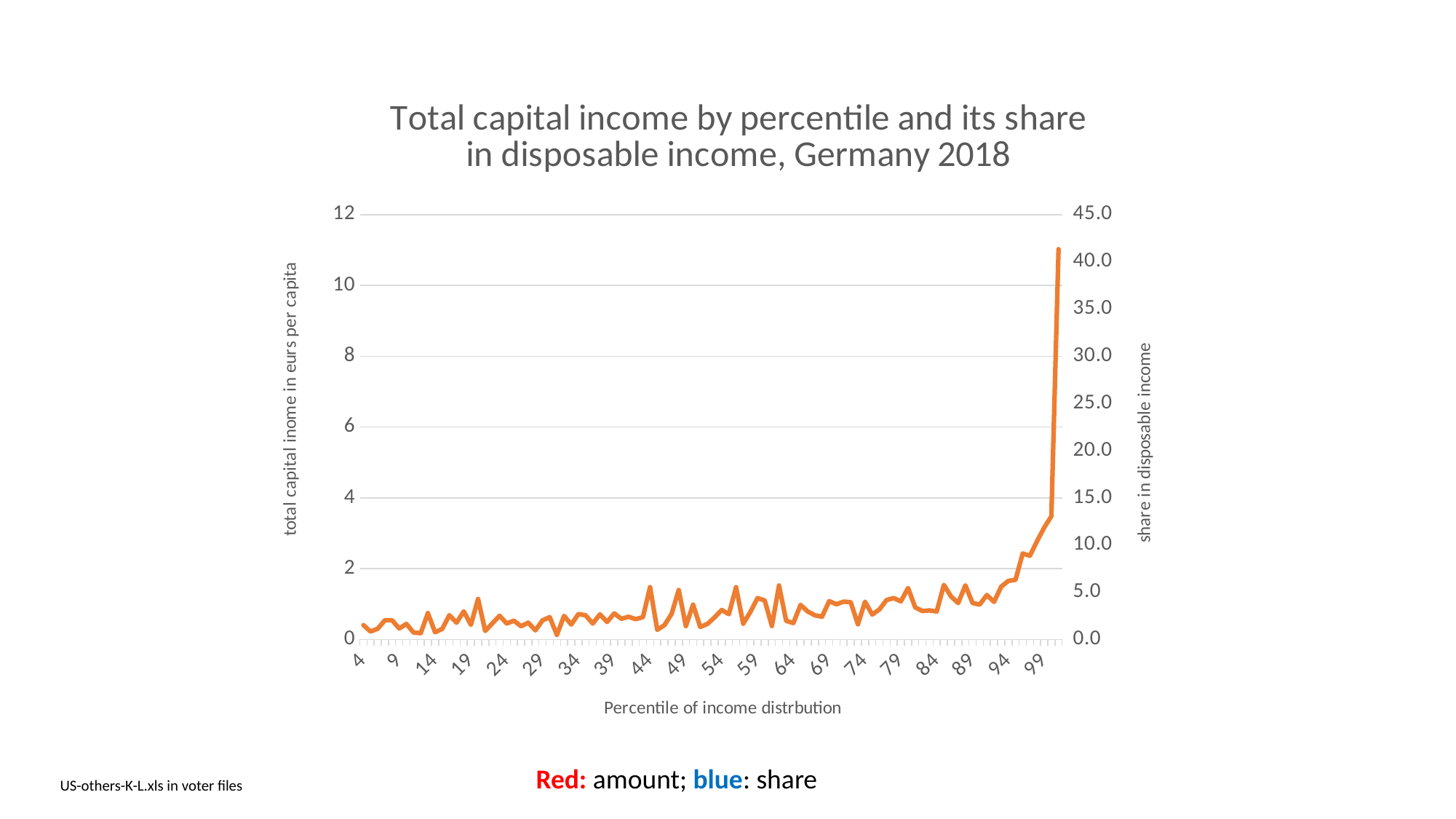
Is the value at percentile 99 greater or less than 4 on the left axis? less Is the value at the far right end of the line larger or smaller than the value at percentile 4? larger What kind of chart is shown on the slide? line chart What is the title of the chart? Total capital income by percentile and its share in disposable income, Germany 2018 Is the peak value of the line at the far right greater or less than 10 on the left axis? greater How many percentile labels are printed along the x axis? 20 Is the value at percentile 4 greater or less than 2 on the left axis? less What is the label of the x axis? Percentile of income distrbution Overall, do the plotted values rise or fall as the percentile increases along the x axis? rise Where along the x axis does the line reach its highest value? at the far right end (top percentile)